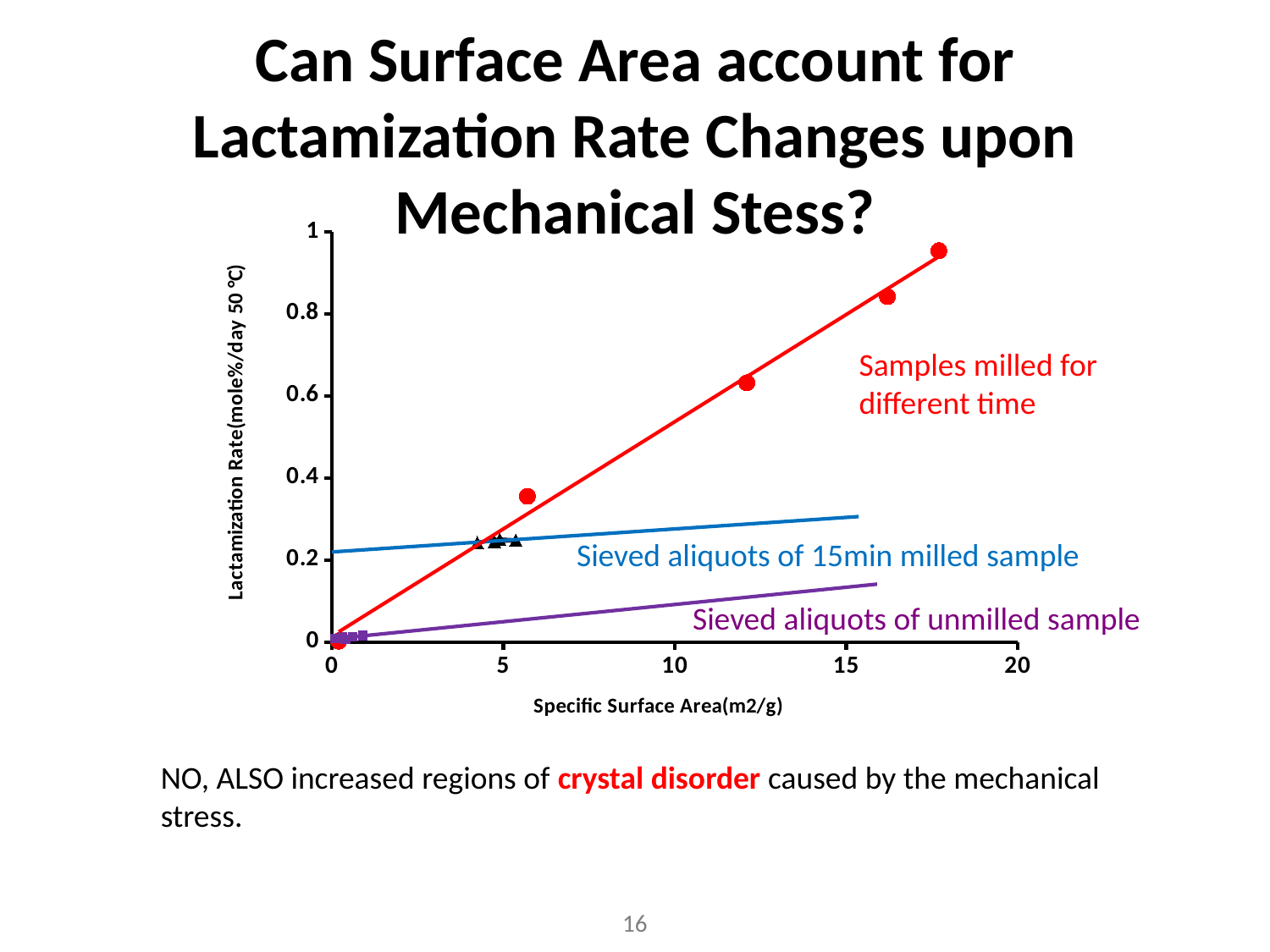
What is the title of the y axis of the chart? Lactamization Rate(mole%/day 50 °C) Does the lactamization rate of the Samples milled for different time rise or fall as specific surface area increases? rise What kind of chart is shown on the slide? scatter chart What is the title of the x axis of the chart? Specific Surface Area(m2/g) What is the maximum value shown on the x axis of the chart? 20 Are the lactamization rates of the Sieved aliquots of 15min milled sample (black triangles) greater or less than 0.2? greater Is the lactamization rate of the highest red point (Samples milled for different time) greater or less than 0.8? greater Is the lactamization rate of the red point at a specific surface area of about 12 m2/g greater or less than 0.6? greater Which series has the lowest lactamization rates on the chart? Sieved aliquots of unmilled sample Which series reaches the highest lactamization rate on the chart? Samples milled for different time